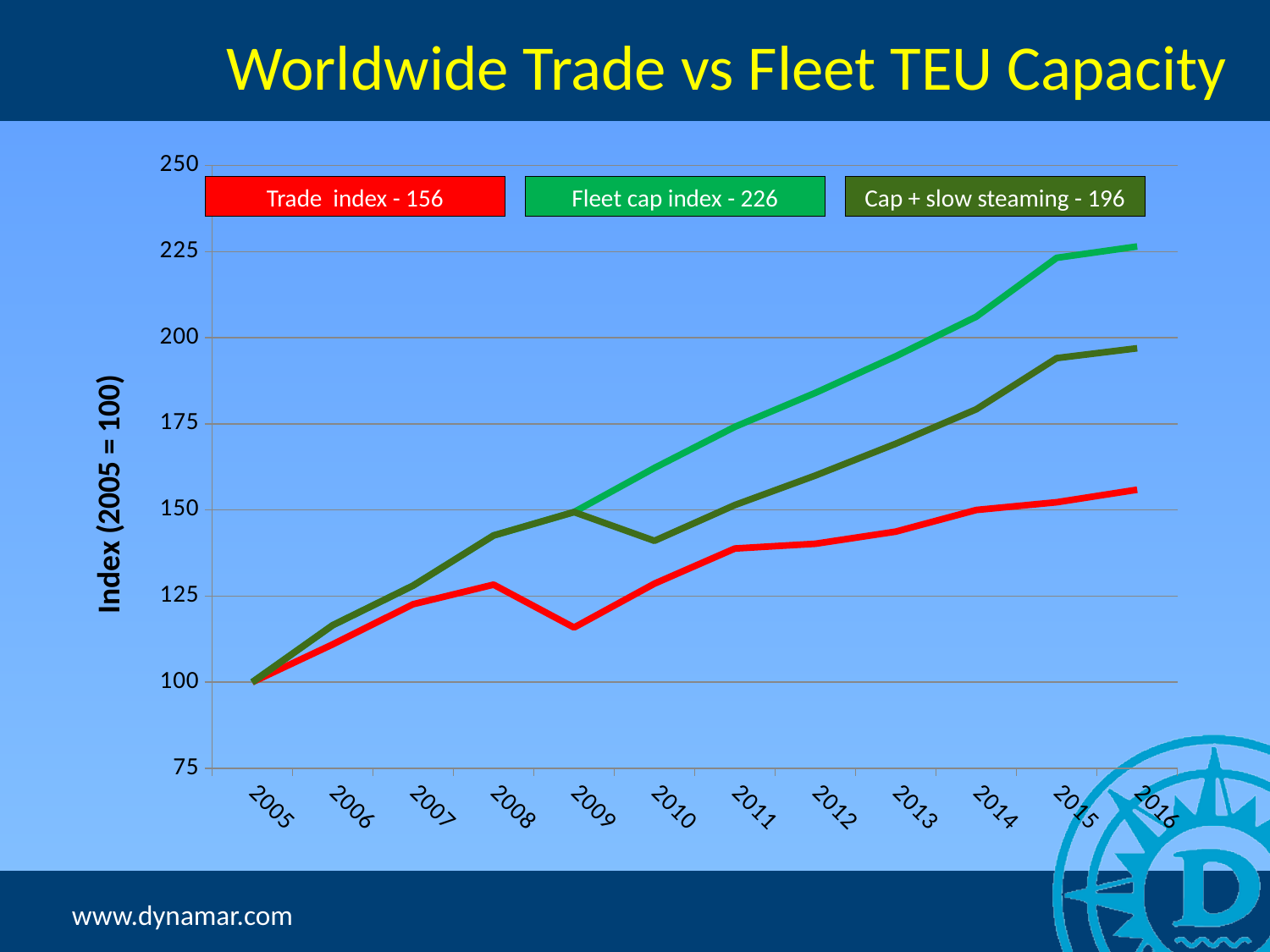
How many series does the legend list? 3 Which series has the highest value in 2016? Fleet cap index What value does the legend give for the Fleet cap index? 226 What is the difference between the Fleet cap index value (226) and the Trade index value (156) given in the legend? 70 How many years are shown on the x axis? 12 Is the value for the Trade index in 2009 greater or less than 125? less In 2010, which is larger: the Fleet cap index or Cap + slow steaming? Fleet cap index Which series has the lowest value in 2016? Trade index What type of chart is shown on the slide? line chart What is the title of the chart? Worldwide Trade vs Fleet TEU Capacity What value does the legend give for the Trade index? 156 What value does the legend give for Cap + slow steaming? 196